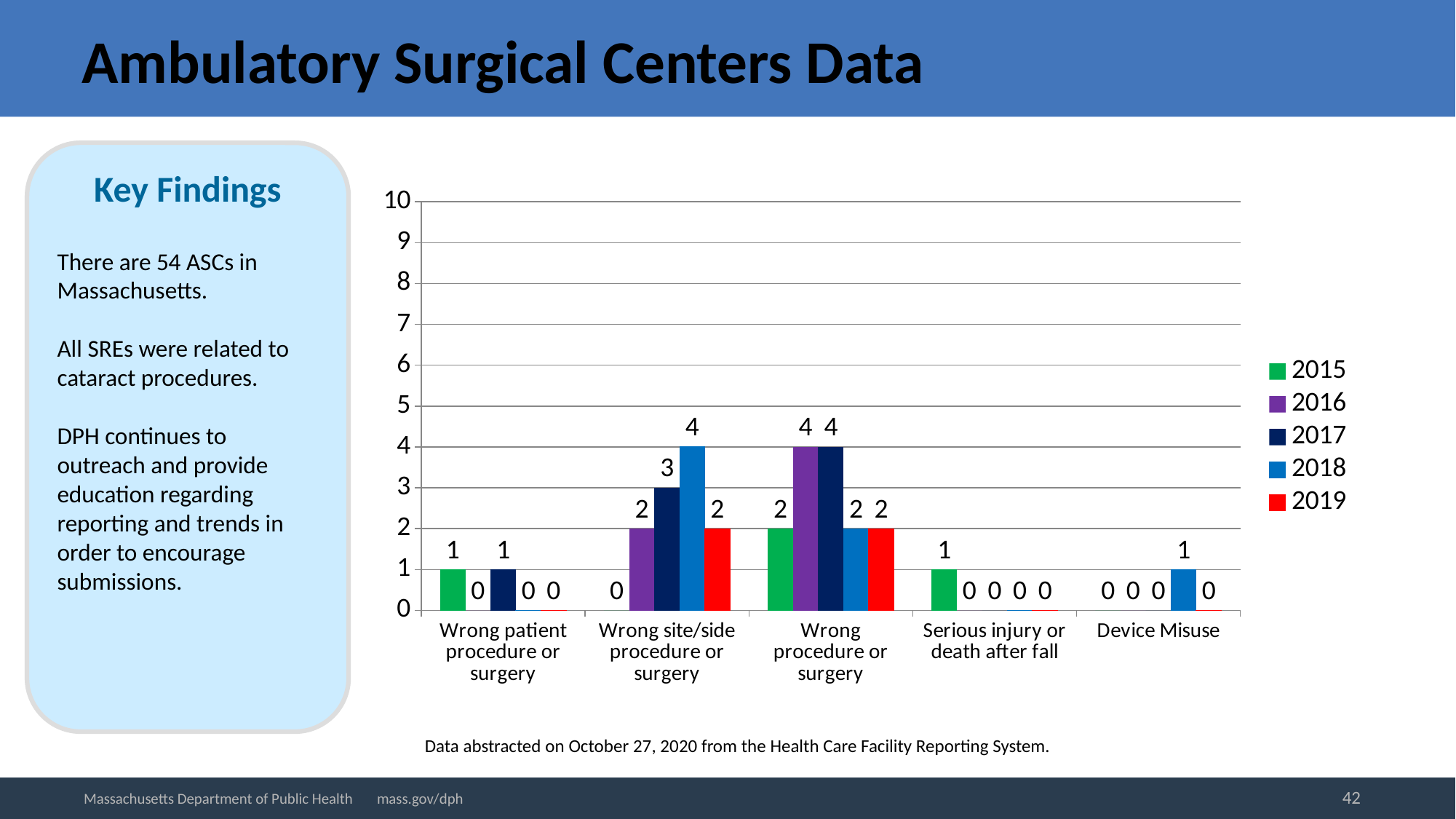
What is the value for 2018 in the Wrong site/side procedure or surgery category? 4 Which colour represents 2019 in the legend? Red What is the value for 2015 in the Wrong procedure or surgery category? 2 What is the value for 2018 in the Device Misuse category? 1 How many categories are shown on the x axis? 5 Which year has the lowest value in the Wrong site/side procedure or surgery category? 2015 What is the value for 2017 in the Wrong site/side procedure or surgery category? 3 What kind of chart is shown on the slide? Bar chart Which year has the highest value in the Wrong site/side procedure or surgery category? 2018 In the Wrong procedure or surgery category, which is larger: the 2016 value or the 2018 value? 2016 How many series does the legend list? 5 What is the difference between the 2018 and 2016 values in the Wrong site/side procedure or surgery category? 2